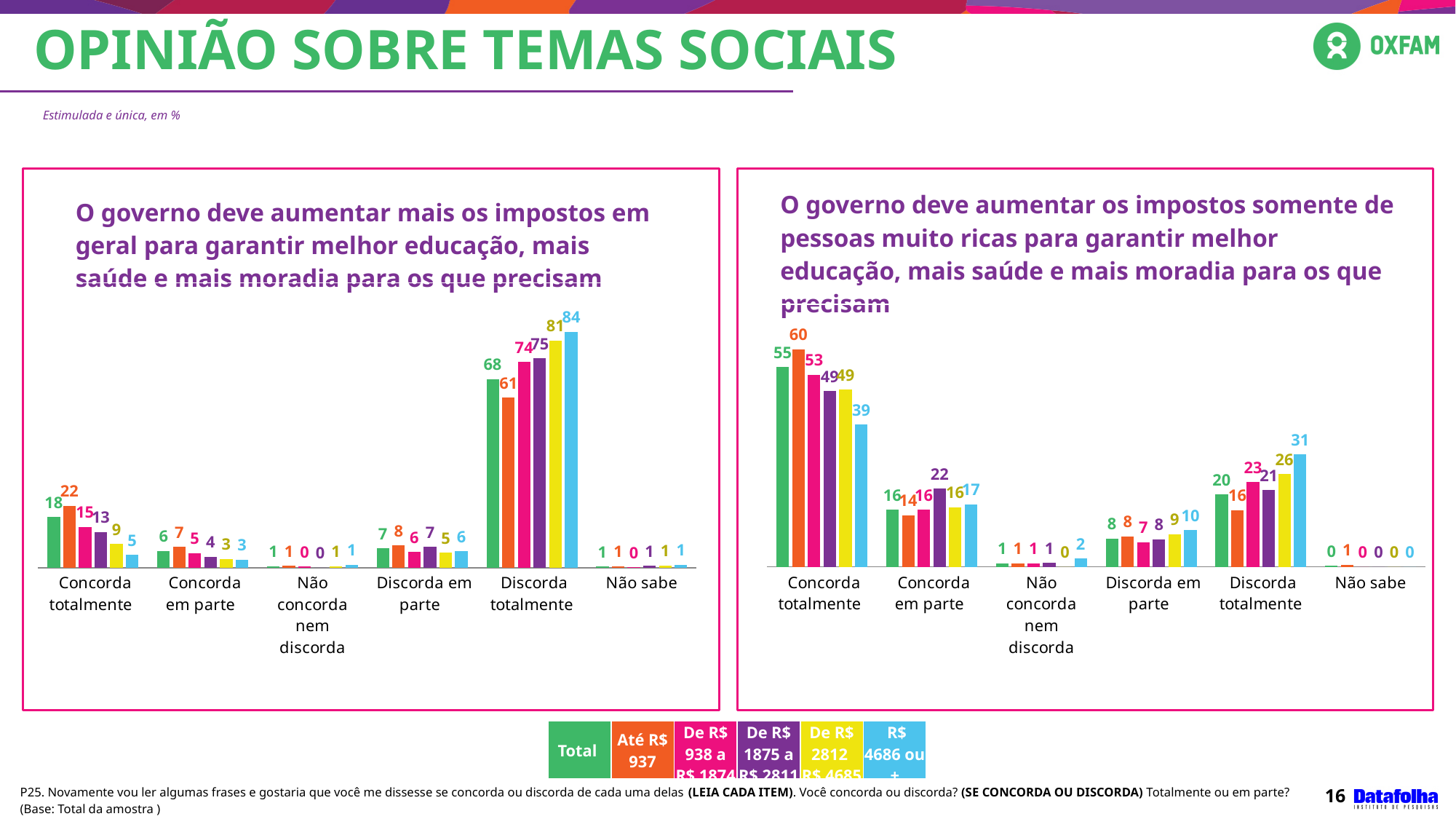
In the left chart, what is the value for 'Concorda totalmente' in the 'R$ 4686 ou +' series? 5 In the left chart, which category has the highest Total value? Discorda totalmente How many series does the legend list? 6 In the left chart, what is the difference between the 'R$ 4686 ou +' value and the 'Até R$ 937' value for 'Discorda totalmente'? 23 How many categories are shown on the x axis of the right chart? 6 In the right chart, which is larger for 'Discorda totalmente': the 'R$ 4686 ou +' value or the Total value? R$ 4686 ou + In the right chart, what is the value for 'Concorda em parte' in the 'De R$ 1875 a R$ 2811' series? 22 In the right chart, which category has the highest Total value? Concorda totalmente In the right chart, what is the value for 'Concorda totalmente' in the 'Até R$ 937' series? 60 Which colour represents the 'Total' series in the legend? Green In the left chart, what is the Total value for 'Discorda totalmente'? 68 What kind of chart is the left chart? Bar chart